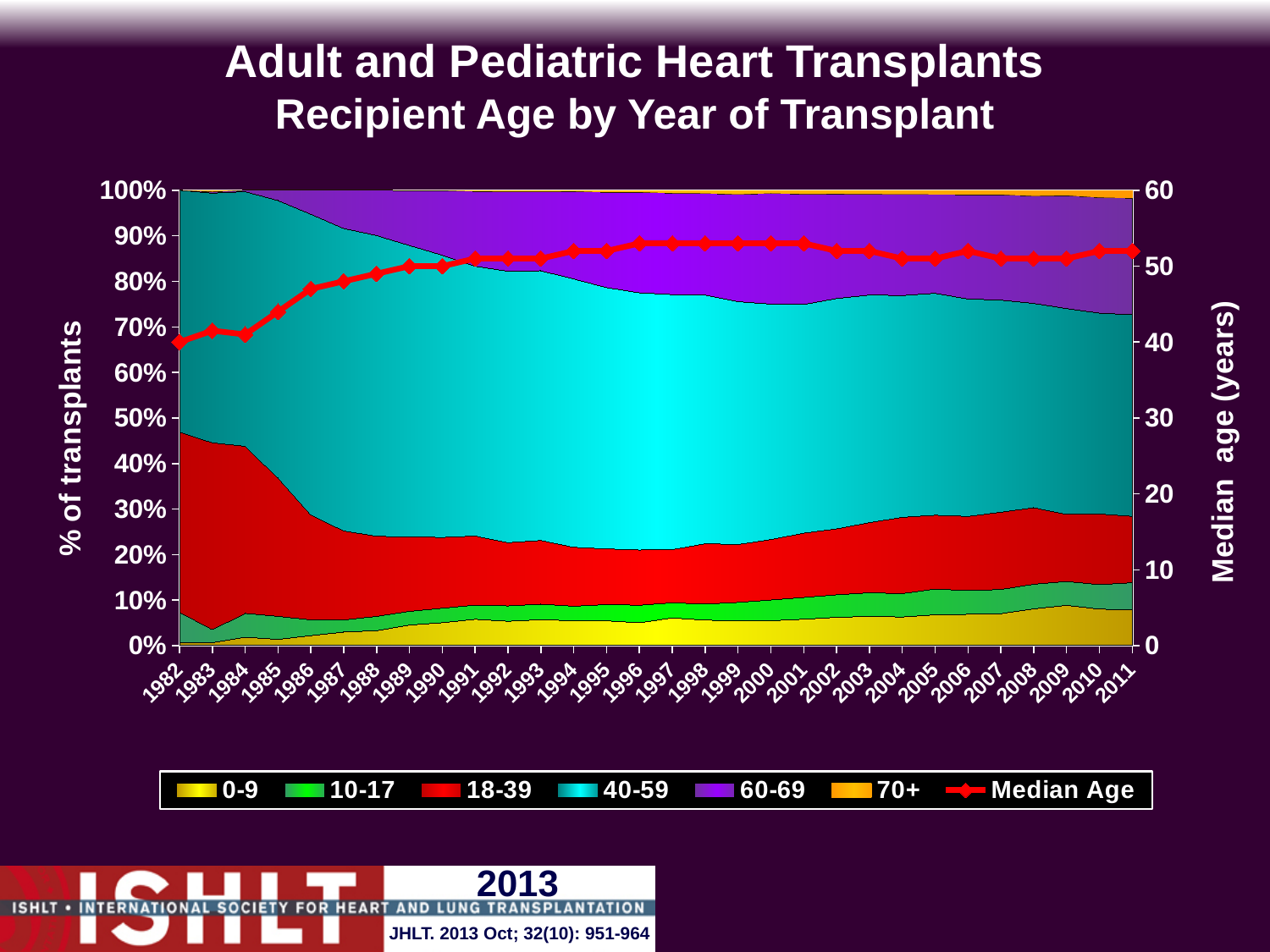
Does the median age line generally rise or fall from 1982 to 2011? Rise How many series does the legend list? 7 Is the median age in 2000 greater or less than 50 years? greater Which year has the larger median age, 1982 or 2011? 2011 What kind of chart is shown on the slide? Stacked area chart with a line for median age Is the median age in 1984 greater or less than 50 years? less Which year has the larger median age, 1985 or 1996? 1996 How many years are shown along the x axis? 30 What is the title of the chart? Adult and Pediatric Heart Transplants Recipient Age by Year of Transplant Is the median age in 1982 greater or less than 50 years? less What is the label of the right-hand vertical axis? Median age (years)